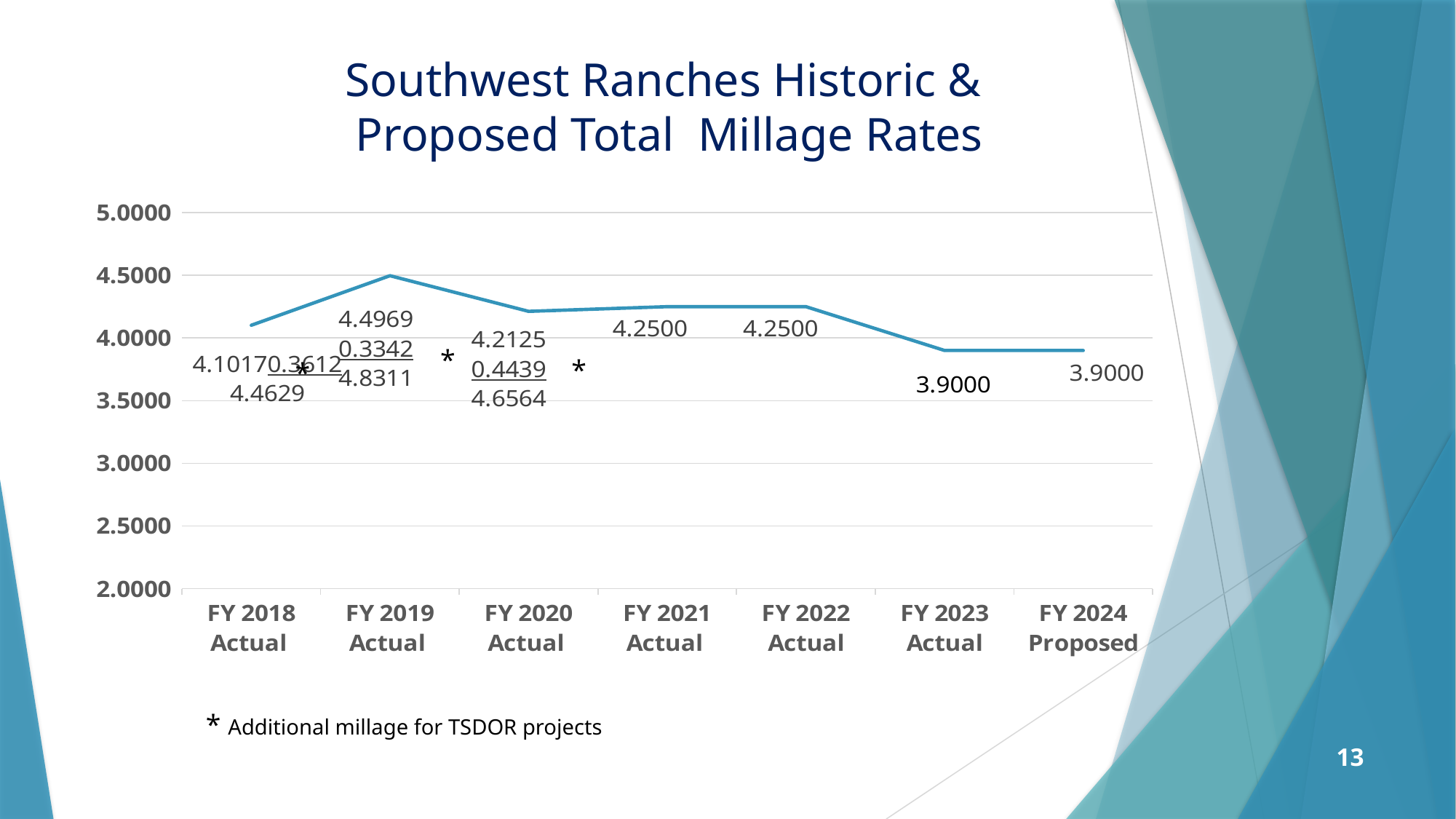
According to the footnote, what does the asterisk on the chart indicate? Additional millage for TSDOR projects What is the difference between the FY 2019 Actual and FY 2018 Actual millage rates? 0.3952 Which is larger, the millage rate for FY 2020 Actual or FY 2021 Actual? FY 2021 Actual What is the total millage rate for FY 2024 Proposed? 3.9000 Do the millage rates rise or fall from FY 2022 Actual to FY 2024 Proposed? fall Which fiscal year has the highest total millage rate? FY 2019 Actual Is the value for FY 2018 Actual greater or less than 4.0000? greater What is the total millage rate for FY 2020 Actual? 4.2125 What is the total millage rate for FY 2019 Actual? 4.4969 How many fiscal years are plotted on the chart? 7 What is the lowest total millage rate shown on the chart? 3.9000 What kind of chart is shown on the slide? line chart